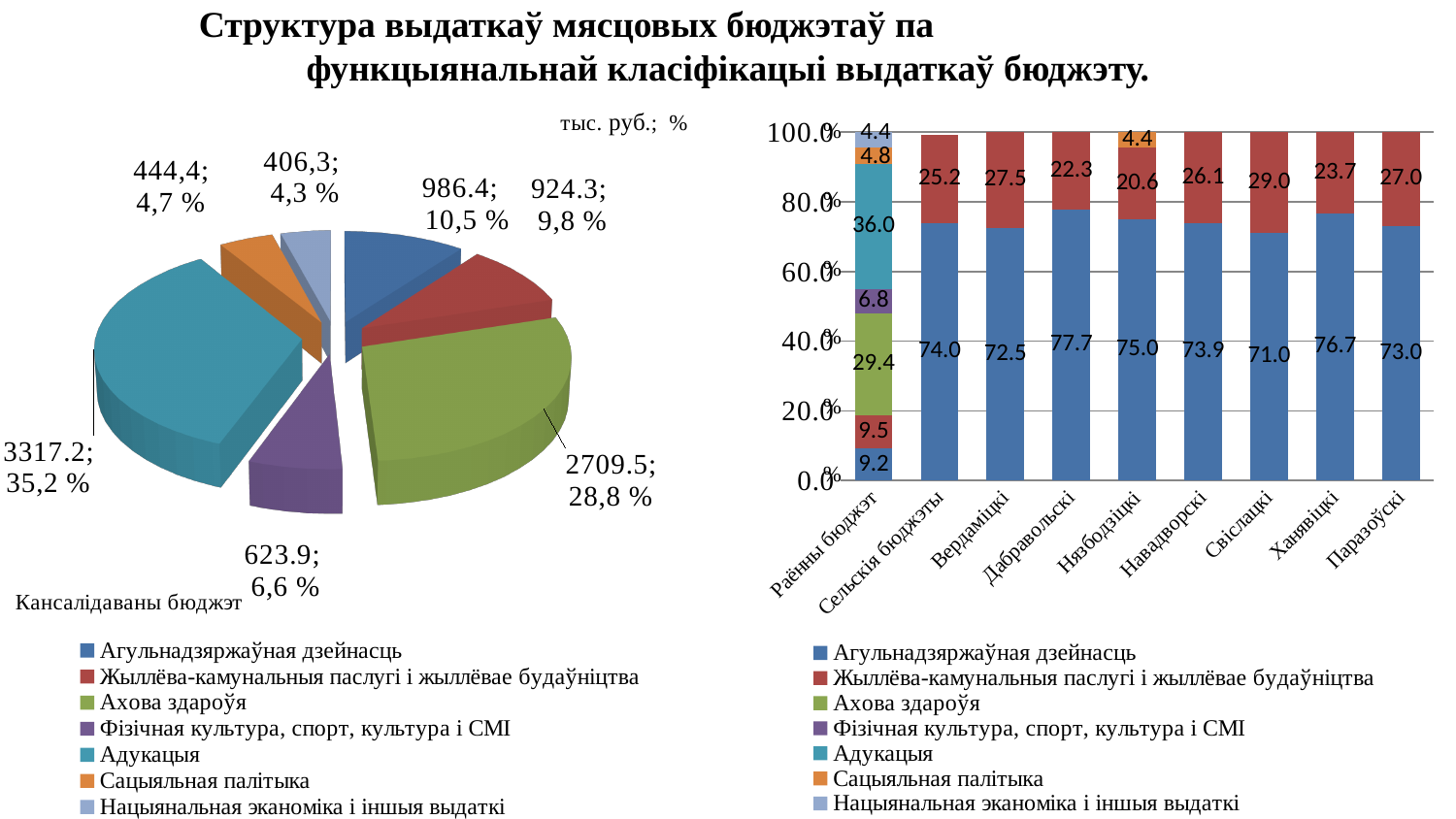
In the stacked bar chart on the right, which budget has the highest value for Агульнадзяржаўная дзейнасць? Дабравольскі In the pie chart on the left, what is the value (тыс. руб.) for Ахова здароўя? 2709.5 In the stacked bar chart on the right, what is the difference between the Агульнадзяржаўная дзейнасць values for Ханявіцкі and Свіслацкі? 5.7 In the pie chart on the left, which category has the largest share? Адукацыя In the pie chart on the left, which category has the smallest share? Нацыянальная эканоміка і іншыя выдаткі In the pie chart on the left, how many slices are there? 7 In the stacked bar chart on the right, how many categories are shown on the x axis? 9 In the stacked bar chart on the right, which budget has the lowest value for Жыллёва-камунальныя паслугі і жыллёвае будаўніцтва among the rural budgets (excluding Раённы бюджэт)? Нязбодзіцкі In the stacked bar chart on the right, what is the value of Агульнадзяржаўная дзейнасць for Дабравольскі? 77.7 What type of chart is shown on the right side of the slide? Stacked bar chart In the stacked bar chart on the right, what is the value of Адукацыя for Раённы бюджэт? 36.0 In the pie chart on the left, what share does Адукацыя have? 35,2 %